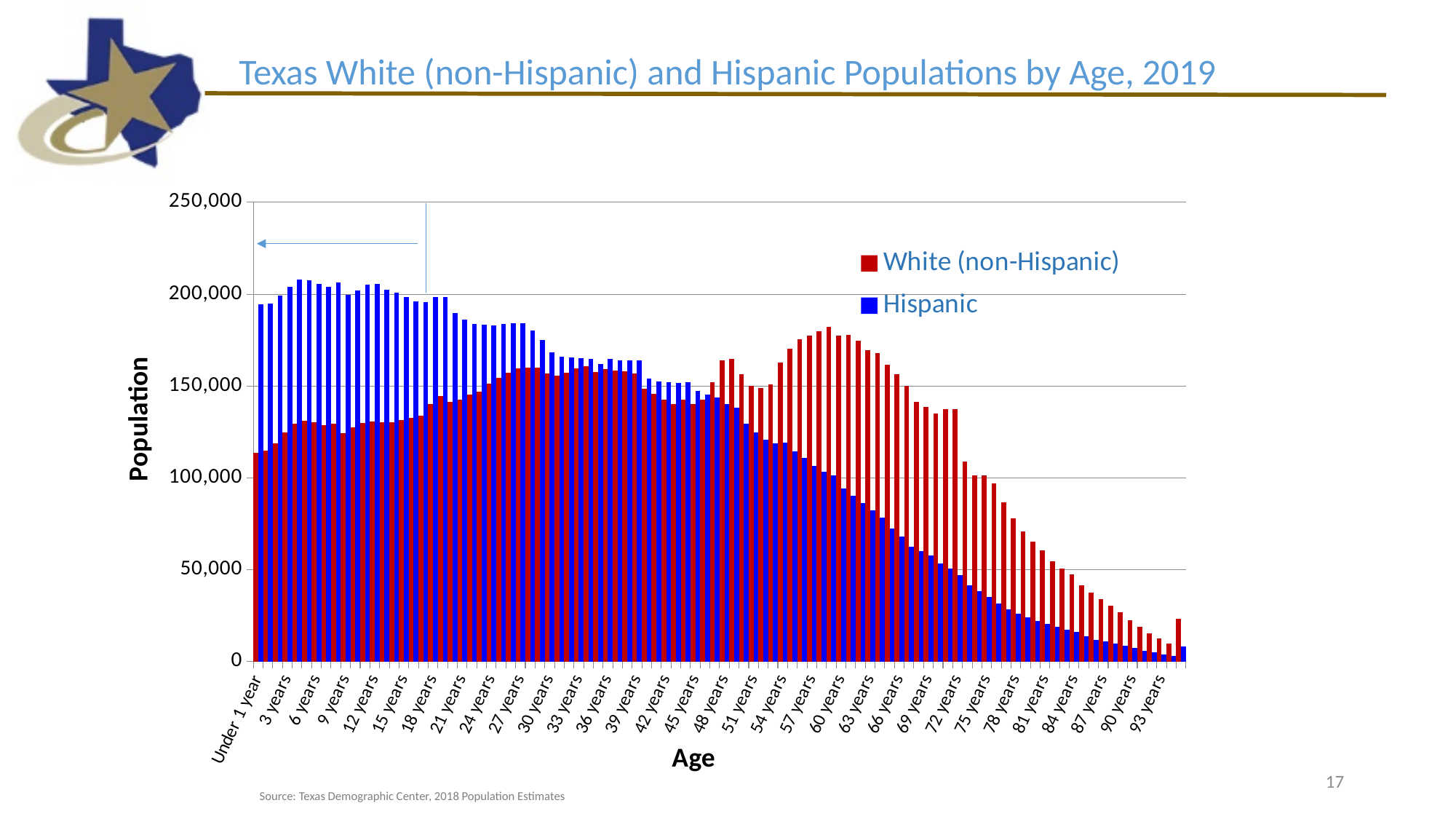
Which series reaches the highest value anywhere on the chart? Hispanic What kind of chart is shown on the slide? Bar chart Is the White (non-Hispanic) value for Under 1 year greater or less than 150,000? less Is the Hispanic value for 93 years greater or less than 50,000? less Is the Hispanic value for 6 years greater or less than 200,000? greater What is the title of the x axis? Age Which series is shown in blue? Hispanic At Under 1 year, which series has the larger value, White (non-Hispanic) or Hispanic? Hispanic At 60 years, which series has the larger value, White (non-Hispanic) or Hispanic? White (non-Hispanic) How many series does the legend list? 2